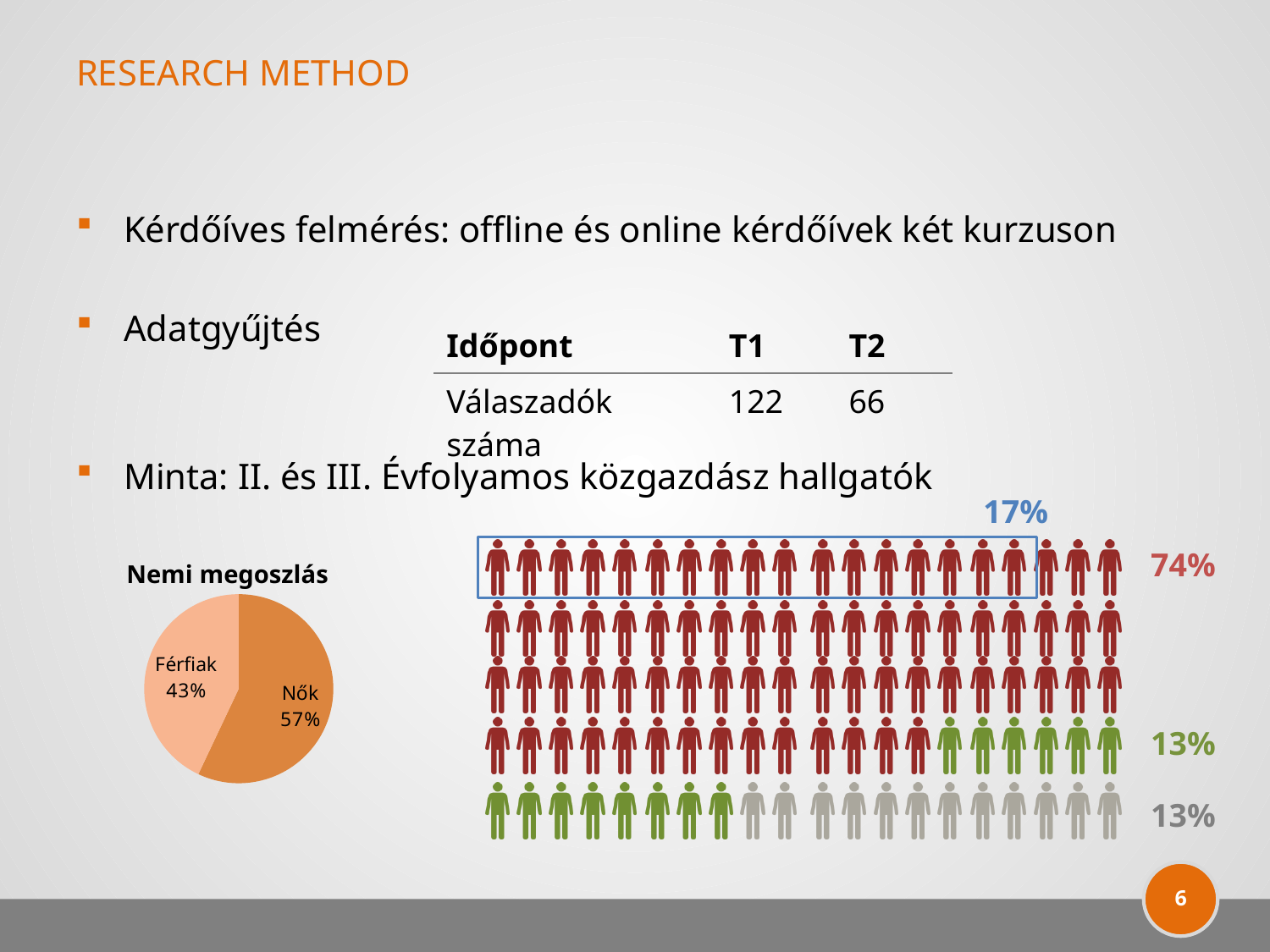
In the 'Nemi megoszlás' pie chart, which slice is the largest? Nők In the pictogram chart of people icons on the right, which colour group has the largest percentage? Red (74%) In the 'Nemi megoszlás' pie chart, which slice is the smallest? Férfiak What is the title of the pie chart on the left of the slide? Nemi megoszlás In the 'Nemi megoszlás' pie chart, which is larger, the Férfiak slice or the Nők slice? Nők In the 'Nemi megoszlás' pie chart, what percentage is shown for Férfiak? 43% What kind of chart is the 'Nemi megoszlás' chart on the left of the slide? Pie chart In the pictogram chart of people icons on the right, what percentage is labelled next to the red figures? 74% In the 'Nemi megoszlás' pie chart, what percentage is shown for Nők? 57% In the 'Nemi megoszlás' pie chart, by how many percentage points does Nők exceed Férfiak? 14 percentage points In the pictogram chart of people icons on the right, what percentage is labelled above the blue-outlined group of figures? 17% How many slices does the 'Nemi megoszlás' pie chart have? 2